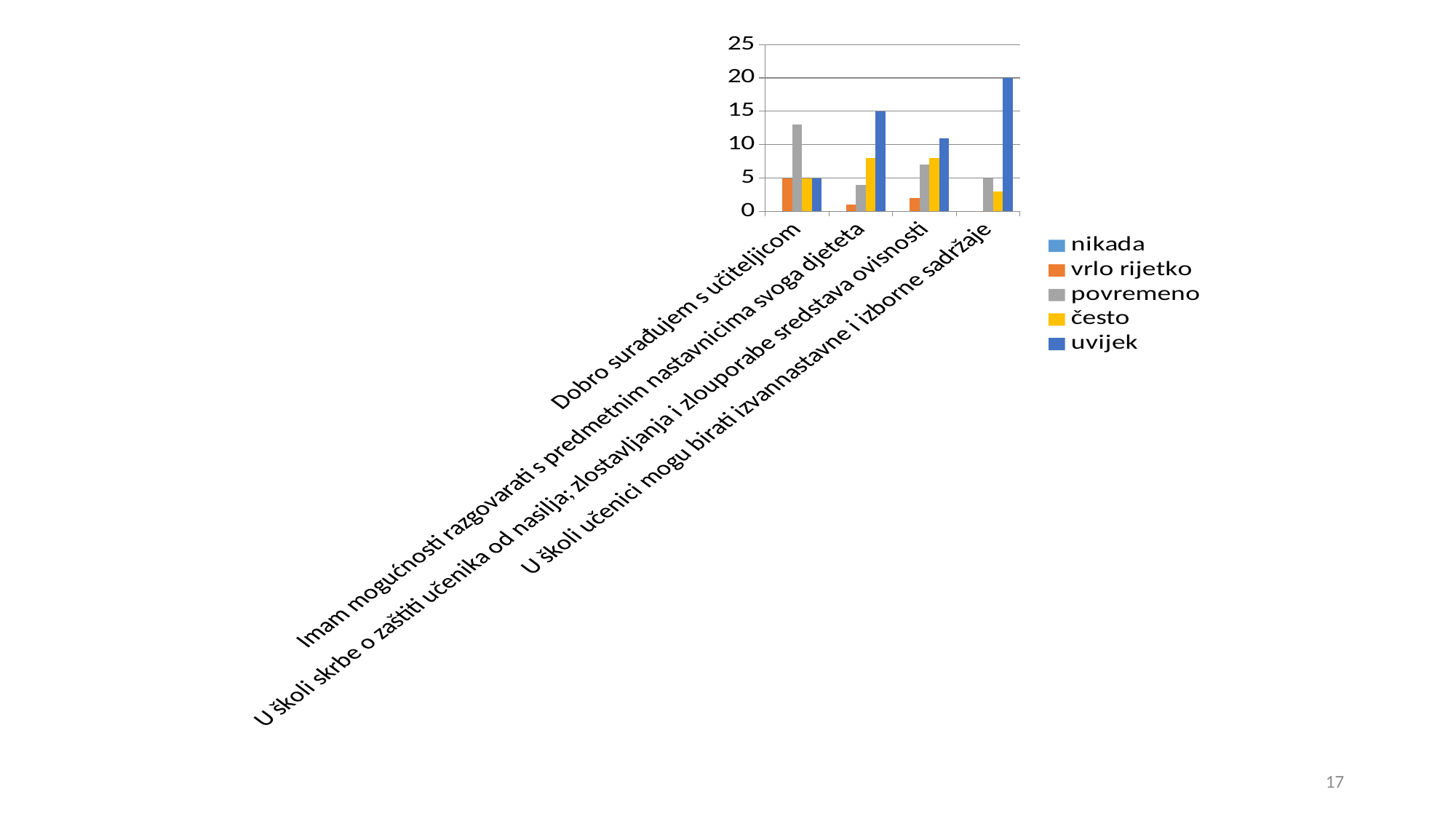
For 'U školi učenici mogu birati izvannastavne i izborne sadržaje', which is larger: 'uvijek' or 'često'? uvijek What colour represents the 'uvijek' series in the legend? blue Is the 'povremeno' value for 'Dobro surađujem s učiteljicom' greater or less than 10? greater For 'Dobro surađujem s učiteljicom', which is larger: 'povremeno' or 'uvijek'? povremeno What is the value of 'uvijek' for 'U školi učenici mogu birati izvannastavne i izborne sadržaje'? 20 How many series does the legend list? 5 Which category has the highest 'uvijek' value? U školi učenici mogu birati izvannastavne i izborne sadržaje What is the value of 'uvijek' for 'Imam mogućnosti razgovarati s predmetnim nastavnicima svoga djeteta'? 15 How many categories are shown on the x axis? 4 What is the difference between the 'uvijek' value for 'U školi učenici mogu birati izvannastavne i izborne sadržaje' and the 'uvijek' value for 'Imam mogućnosti razgovarati s predmetnim nastavnicima svoga djeteta'? 5 Is the 'uvijek' value for 'U školi skrbe o zaštiti učenika od nasilja, zlostavljanja i zlouporabe sredstava ovisnosti' greater or less than 15? less What kind of chart is shown on the slide? bar chart